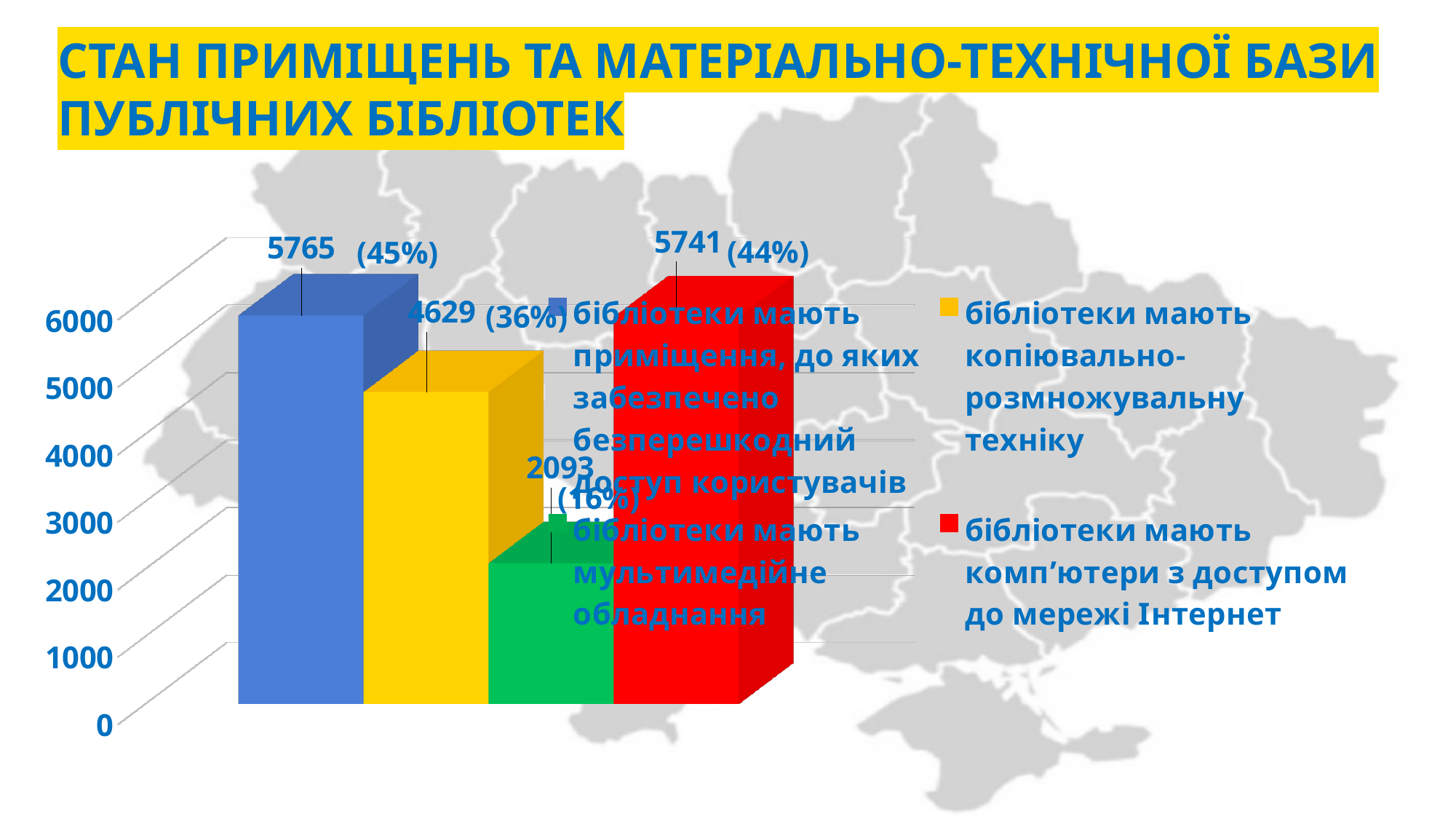
Which series has the lowest value? бібліотеки мають мультимедійне обладнання What percentage is printed next to the value for libraries with multimedia equipment (green bar)? 16% What is the difference between the blue bar (5765) and the yellow bar (4629)? 1136 What value is shown for the yellow bar (бібліотеки мають копіювально-розмножувальну техніку)? 4629 What value is shown for the green bar (бібліотеки мають мультимедійне обладнання)? 2093 Which series has the highest value? бібліотеки мають приміщення, до яких забезпечено безперешкодний доступ користувачів What kind of chart is shown on the slide? bar chart What is the difference between the red bar (5741) and the green bar (2093)? 3648 What value is shown for the blue bar (бібліотеки мають приміщення, до яких забезпечено безперешкодний доступ користувачів)? 5765 What value is shown for the red bar (бібліотеки мають комп'ютери з доступом до мережі Інтернет)? 5741 Which is larger: the value for libraries with copying equipment (yellow) or libraries with multimedia equipment (green)? бібліотеки мають копіювально-розмножувальну техніку How many bars are plotted on the chart? 4